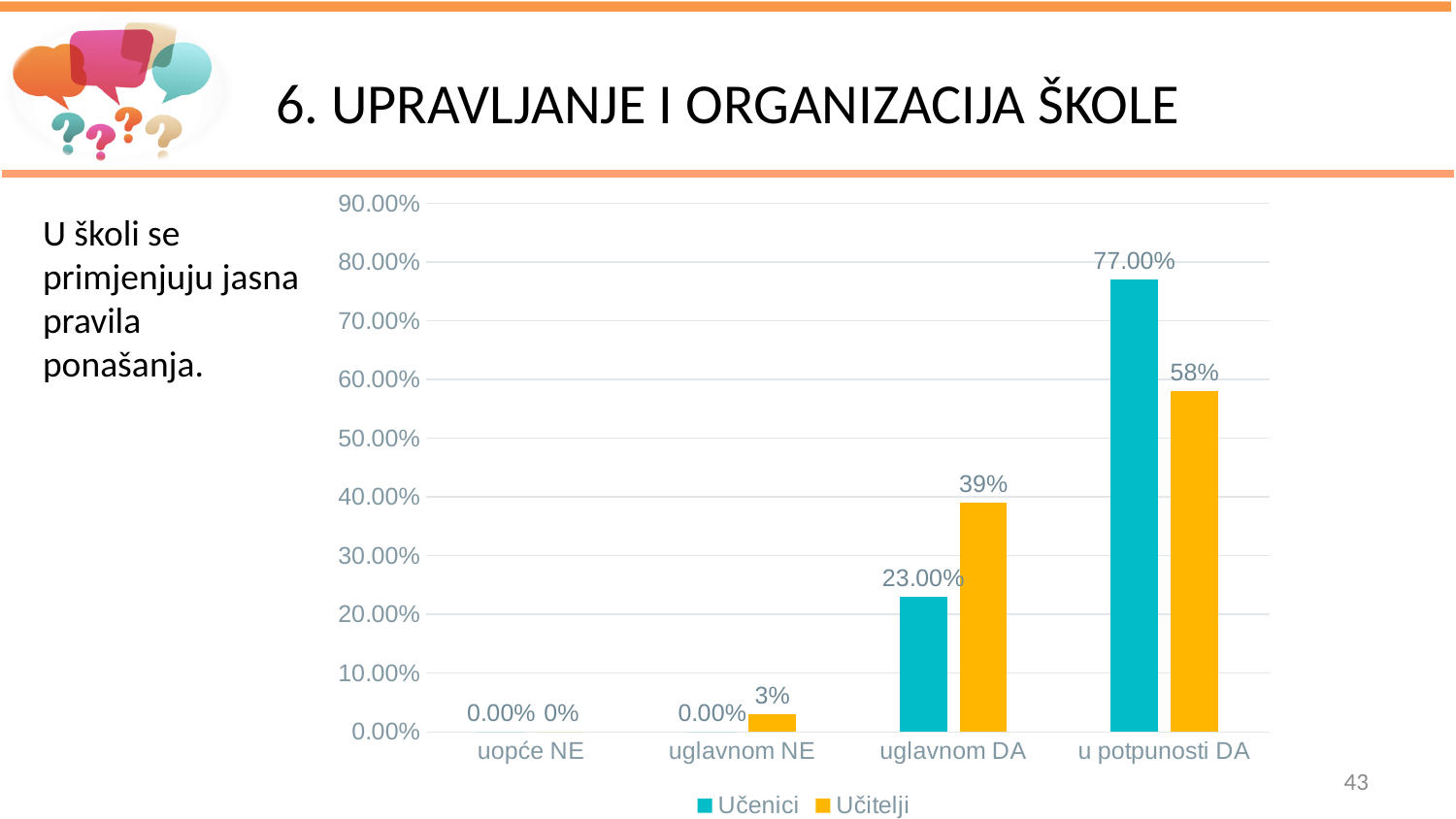
In the 'uglavnom DA' category, which series has the larger value, Učenici or Učitelji? Učitelji What is the difference between the Učenici and Učitelji values in the 'u potpunosti DA' category? 19 percentage points How many categories are shown on the x axis? 4 What is the value for Učitelji in the 'uglavnom NE' category? 3% Which colour represents the Učitelji series? Yellow Which category has the lowest value for Učitelji? uopće NE What is the value for Učenici in the 'uglavnom DA' category? 23.00% How many series does the legend list? 2 Which category has the highest value for Učitelji? u potpunosti DA What is the value for Učitelji in the 'uglavnom DA' category? 39% What kind of chart is shown on the slide? Bar chart What is the value for Učenici in the 'u potpunosti DA' category? 77.00%